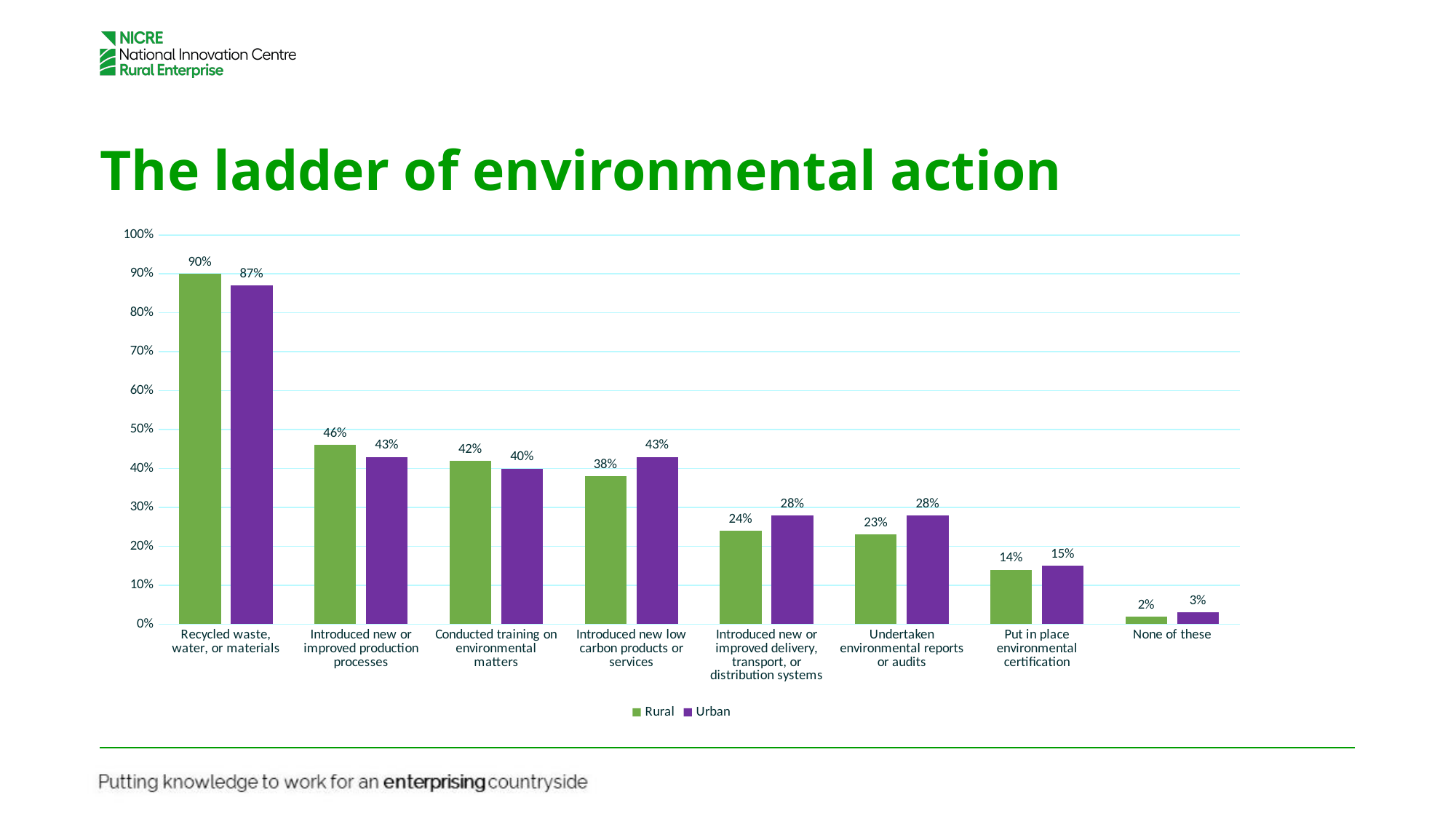
What colour are the Urban bars? Purple What is the Rural value for "Put in place environmental certification"? 14% What is the Rural value for "Recycled waste, water, or materials"? 90% How many categories are shown on the x axis? 8 Is the Urban value for "Conducted training on environmental matters" greater or less than 50%? less Which category has the lowest Rural value? None of these What is the Urban value for "Introduced new low carbon products or services"? 43% What is the difference between the Rural and Urban values for "Introduced new or improved production processes"? 3% For "Undertaken environmental reports or audits", which is larger, the Rural or the Urban value? Urban What kind of chart is shown on the slide? Bar chart How many series does the legend list? 2 Which category has the highest Urban value? Recycled waste, water, or materials